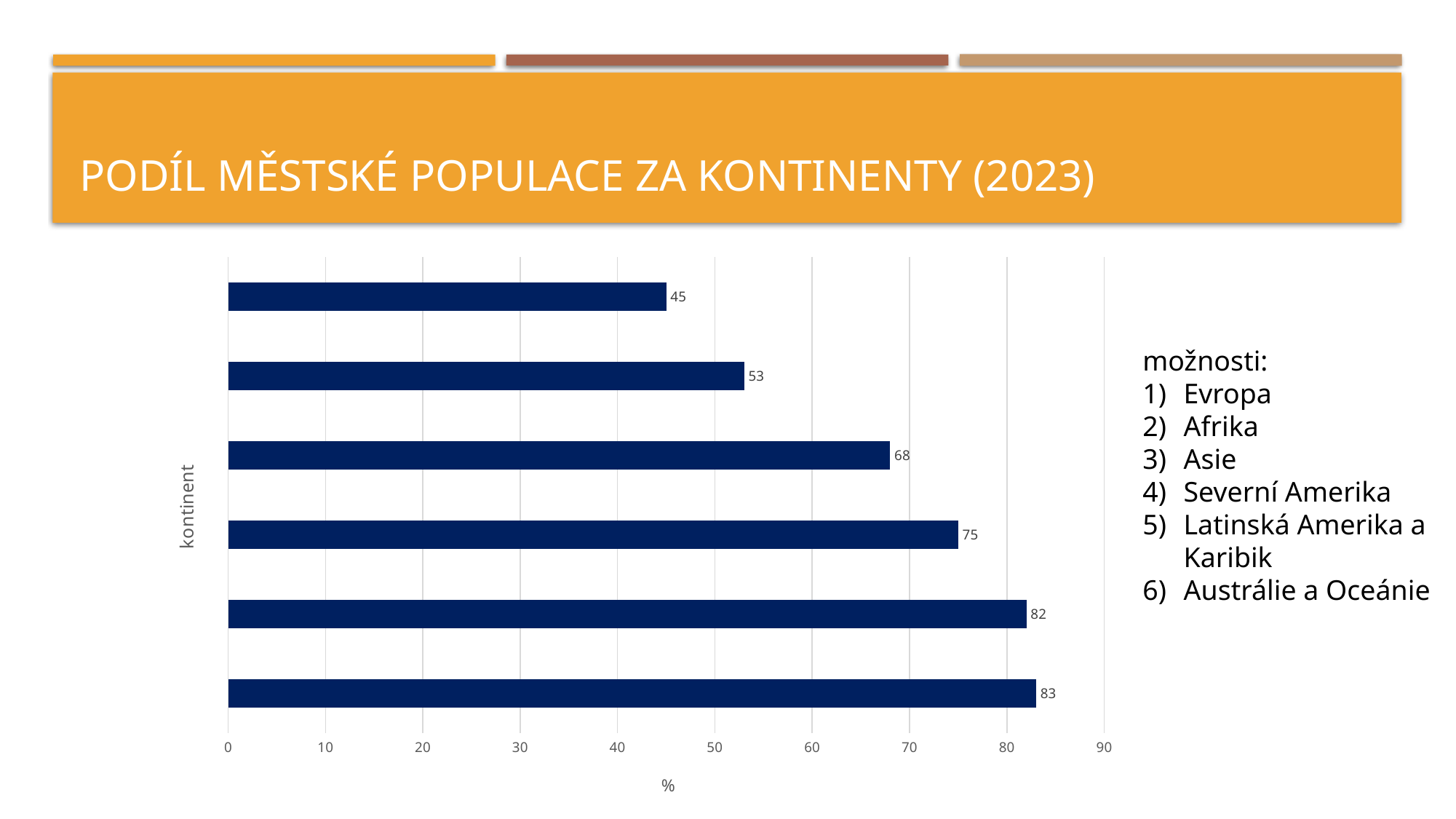
What is the value of the second bar from the top? 53 What is the value of the third bar from the top? 68 What is the difference between the bottom bar (83) and the top bar (45)? 38 How many bars are plotted in the chart? 6 What type of chart is shown on the slide? bar chart What is the value of the topmost bar in the chart? 45 What is the lowest value shown in the chart? 45 What is the title of the chart on the slide? PODÍL MĚSTSKÉ POPULACE ZA KONTINENTY (2023) Which is larger: the fourth bar from the top or the fifth bar from the top? the fifth bar from the top (82) What is the label of the horizontal axis? % What is the value of the bottom bar in the chart? 83 What is the highest value shown in the chart? 83